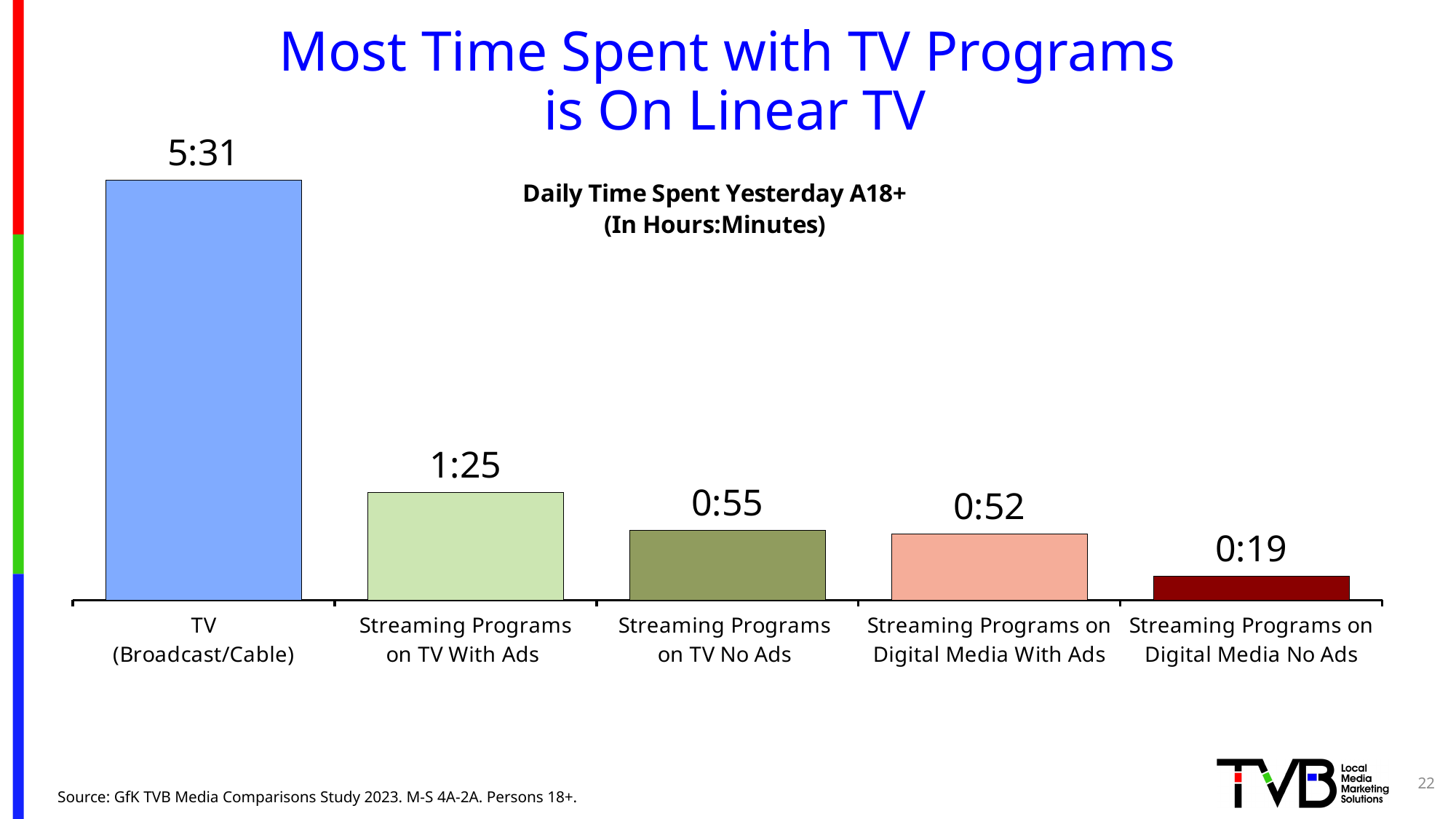
What is the daily time spent for TV (Broadcast/Cable)? 5:31 What is the daily time spent for Streaming Programs on Digital Media No Ads? 0:19 What is the title of the chart? Daily Time Spent Yesterday A18+ (In Hours:Minutes) How much more daily time is spent on TV (Broadcast/Cable) than on Streaming Programs on TV With Ads? 4:06 What is the daily time spent for Streaming Programs on TV No Ads? 0:55 What is the daily time spent for Streaming Programs on TV With Ads? 1:25 Which has a higher daily time spent: Streaming Programs on TV No Ads or Streaming Programs on Digital Media No Ads? Streaming Programs on TV No Ads Which category has the lowest daily time spent? Streaming Programs on Digital Media No Ads How many categories are shown in the chart? 5 What type of chart is shown on the slide? Bar chart What is the daily time spent for Streaming Programs on Digital Media With Ads? 0:52 Which category has the highest daily time spent? TV (Broadcast/Cable)